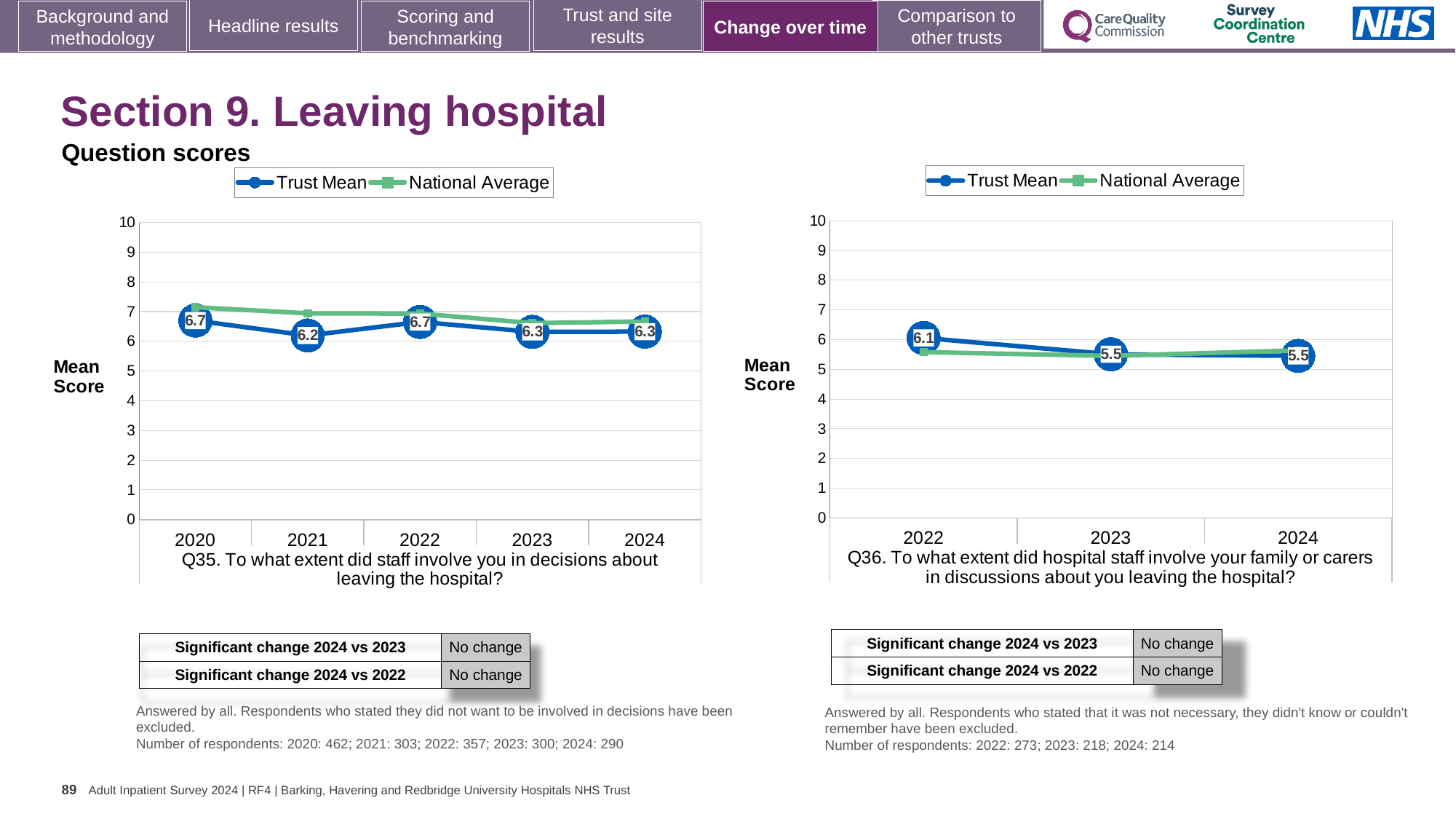
On the Q35 chart (left), is the National Average value for 2024 greater or less than 6? greater On the Q35 chart (left), which year has the larger Trust Mean score, 2021 or 2022? 2022 What kind of chart is the Q36 chart (right)? Line chart On the Q36 chart (right), what is the difference between the Trust Mean scores for 2022 and 2023? 0.6 How many series does the legend of the Q35 chart (left) list? 2 On the Q36 chart (right), which year has the highest Trust Mean score? 2022 On the Q35 chart (left), what is the difference between the Trust Mean scores for 2020 and 2021? 0.5 On the Q35 chart (left), what is the Trust Mean score for 2021? 6.2 On the Q36 chart (right), what is the Trust Mean score for 2022? 6.1 On the Q35 chart (left), which year has the lowest Trust Mean score? 2021 On the Q35 chart (left), what is the Trust Mean score for 2024? 6.3 How many years are plotted on the Q36 chart (right)? 3